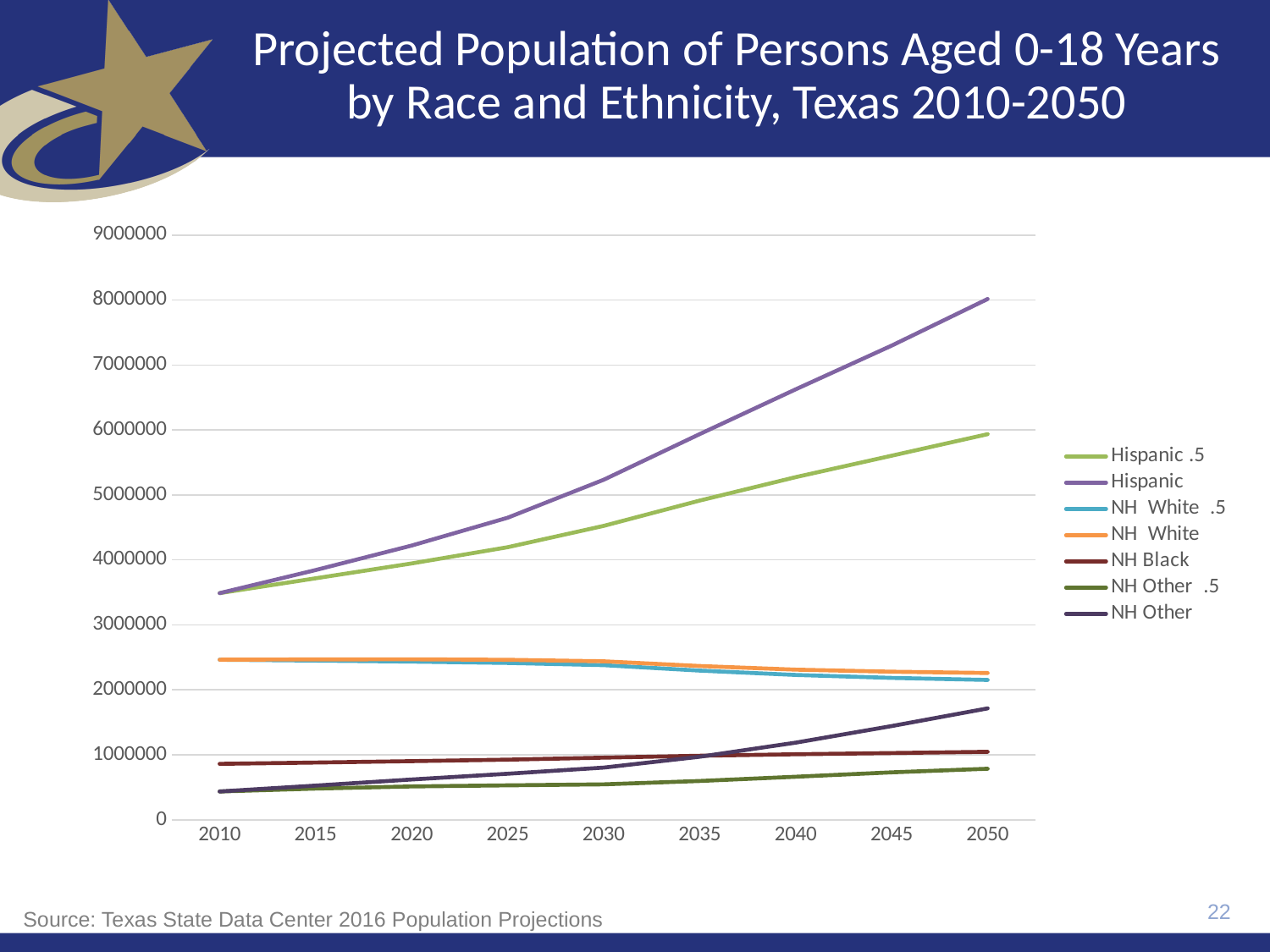
How many series does the legend list? 7 What is the title of the chart? Projected Population of Persons Aged 0-18 Years by Race and Ethnicity, Texas 2010-2050 Which series has the lowest value in 2050? NH Other .5 Does the Hispanic series rise or fall from 2010 to 2050? rise How many years are marked along the x axis? 9 Is the value for Hispanic .5 in 2050 greater or less than 7000000? less Does the NH White series rise or fall from 2010 to 2050? fall Is the value for NH Black in 2010 greater or less than 1000000? less What kind of chart is shown on the slide? line chart In 2050, which is larger: NH Other or NH Black? NH Other Which series has the highest value in 2050? Hispanic Is the value for Hispanic in 2050 greater or less than 7000000? greater